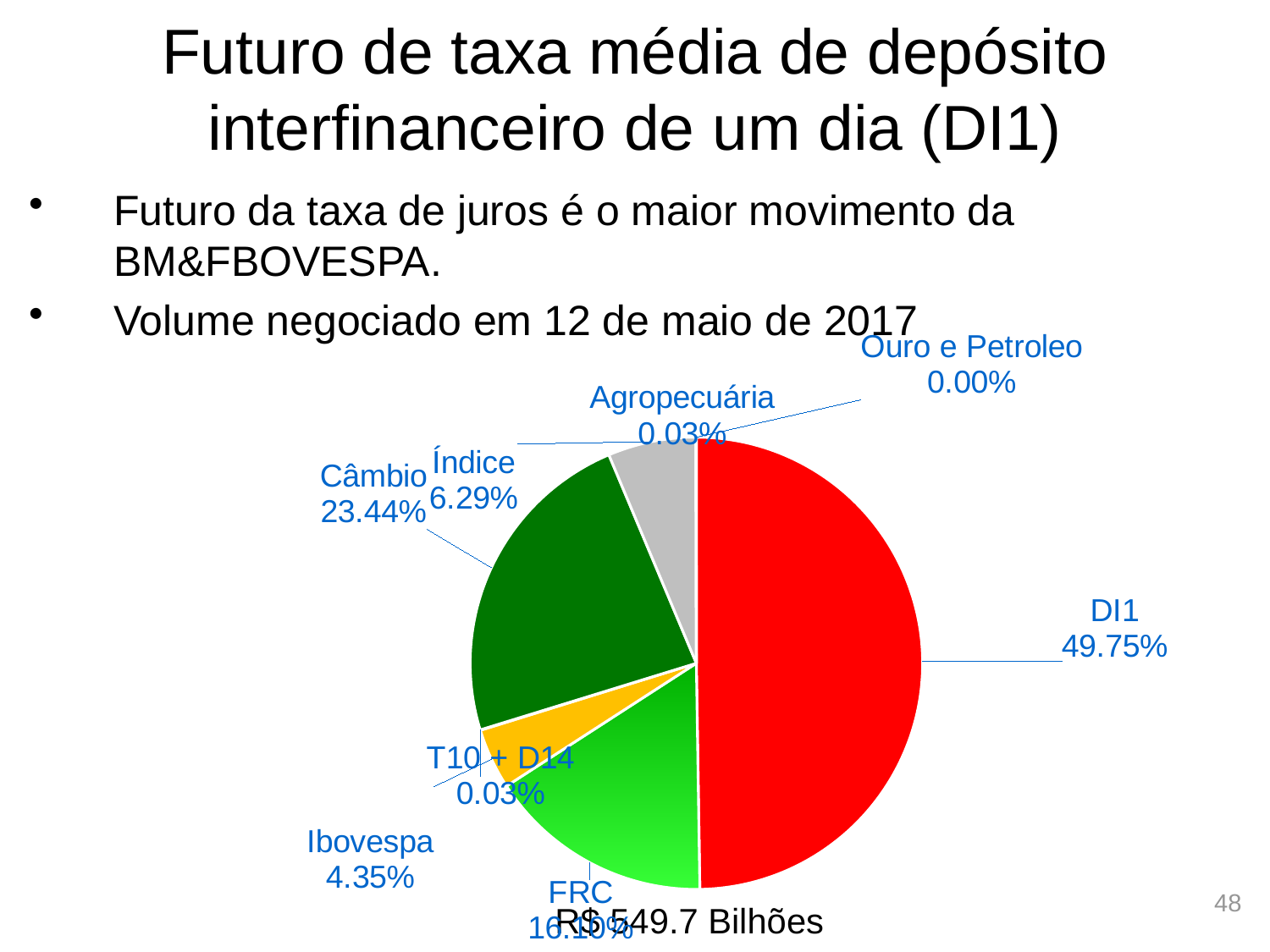
What is the value shown for Câmbio? 23.44% Which category has the smallest slice of the pie? Ouro e Petroleo What is the value shown for Ouro e Petroleo? 0.00% What kind of chart is shown on the slide? pie chart How many slices does the pie chart have? 8 Which is larger, the slice for Câmbio or the slice for Índice? Câmbio What total volume is printed below the pie chart? R$ 549.7 Bilhões What share of the pie does DI1 represent? 49.75% What is the value shown for Ibovespa? 4.35% What is the difference between the DI1 share and the Câmbio share? 26.31% What is the value shown for Índice? 6.29% Which category has the largest slice of the pie? DI1